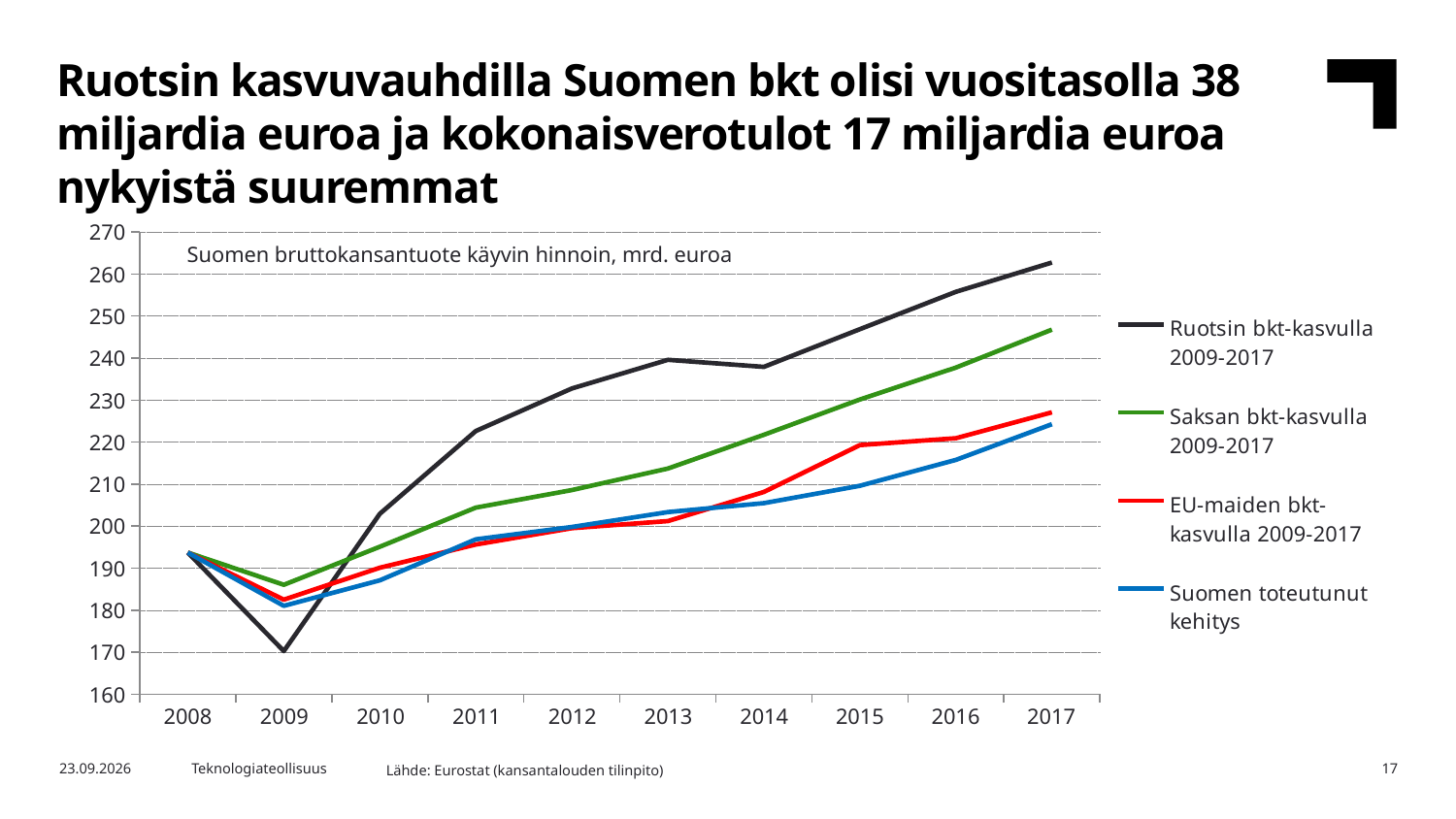
What is the title text shown inside the chart area? Suomen bruttokansantuote käyvin hinnoin, mrd. euroa Is the value for Ruotsin bkt-kasvulla 2009-2017 in 2009 greater or less than 180? less Is the value for Suomen toteutunut kehitys in 2017 greater or less than 230? less How many series does the legend list? 4 Does the Ruotsin bkt-kasvulla 2009-2017 series rise or fall from 2009 to 2017? Rise How many years are shown on the x axis? 10 Which series has the lowest value in 2017? Suomen toteutunut kehitys Which series has the lowest value in 2009? Ruotsin bkt-kasvulla 2009-2017 Which series has the highest value in 2017? Ruotsin bkt-kasvulla 2009-2017 What kind of chart is shown on the slide? Line chart Is the value for Ruotsin bkt-kasvulla 2009-2017 in 2017 greater or less than 250? greater In 2015, which is higher: EU-maiden bkt-kasvulla 2009-2017 or Suomen toteutunut kehitys? EU-maiden bkt-kasvulla 2009-2017